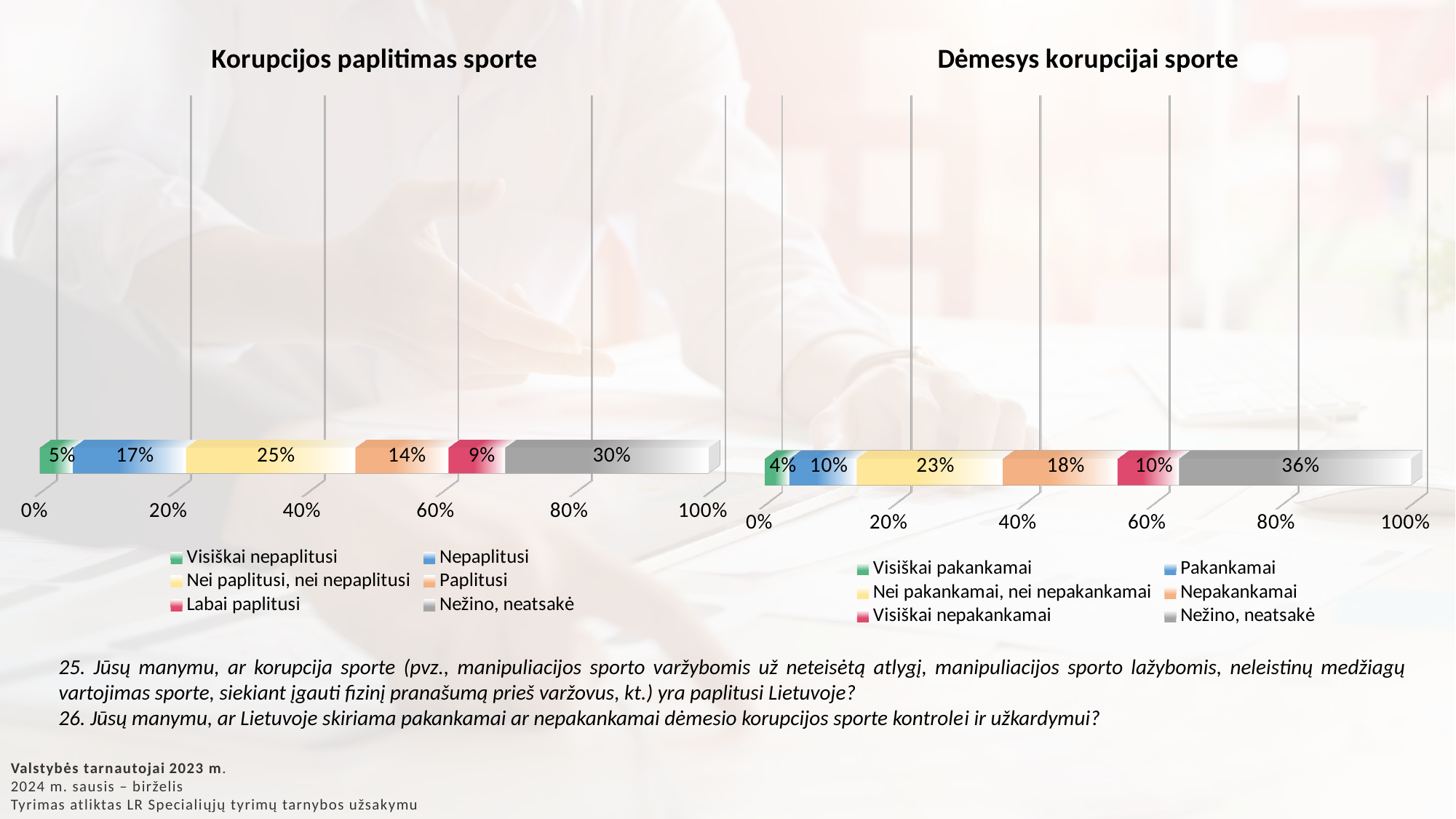
In the chart titled "Korupcijos paplitimas sporte", what is the difference between the values for "Nepaplitusi" and "Visiškai nepaplitusi"? 12% How many series does the legend of the chart titled "Dėmesys korupcijai sporte" list? 6 In the chart titled "Dėmesys korupcijai sporte", what is the value for "Nežino, neatsakė"? 36% In the chart titled "Korupcijos paplitimas sporte", what is the total of the stacked bar? 100% In the chart titled "Dėmesys korupcijai sporte", which series has the smallest value? Visiškai pakankamai In the chart titled "Dėmesys korupcijai sporte", which is larger: the value for "Pakankamai" or the value for "Nepakankamai"? Nepakankamai In the chart titled "Korupcijos paplitimas sporte", which series has the largest value? Nežino, neatsakė In the chart titled "Dėmesys korupcijai sporte", what colour is the segment for "Nei pakankamai, nei nepakankamai"? Yellow In the chart titled "Dėmesys korupcijai sporte", what is the value for "Nepakankamai"? 18% In the chart titled "Korupcijos paplitimas sporte", what is the value for "Nei paplitusi, nei nepaplitusi"? 25% What kind of chart is the chart titled "Korupcijos paplitimas sporte"? Stacked bar chart In the chart titled "Korupcijos paplitimas sporte", what is the value for "Labai paplitusi"? 9%